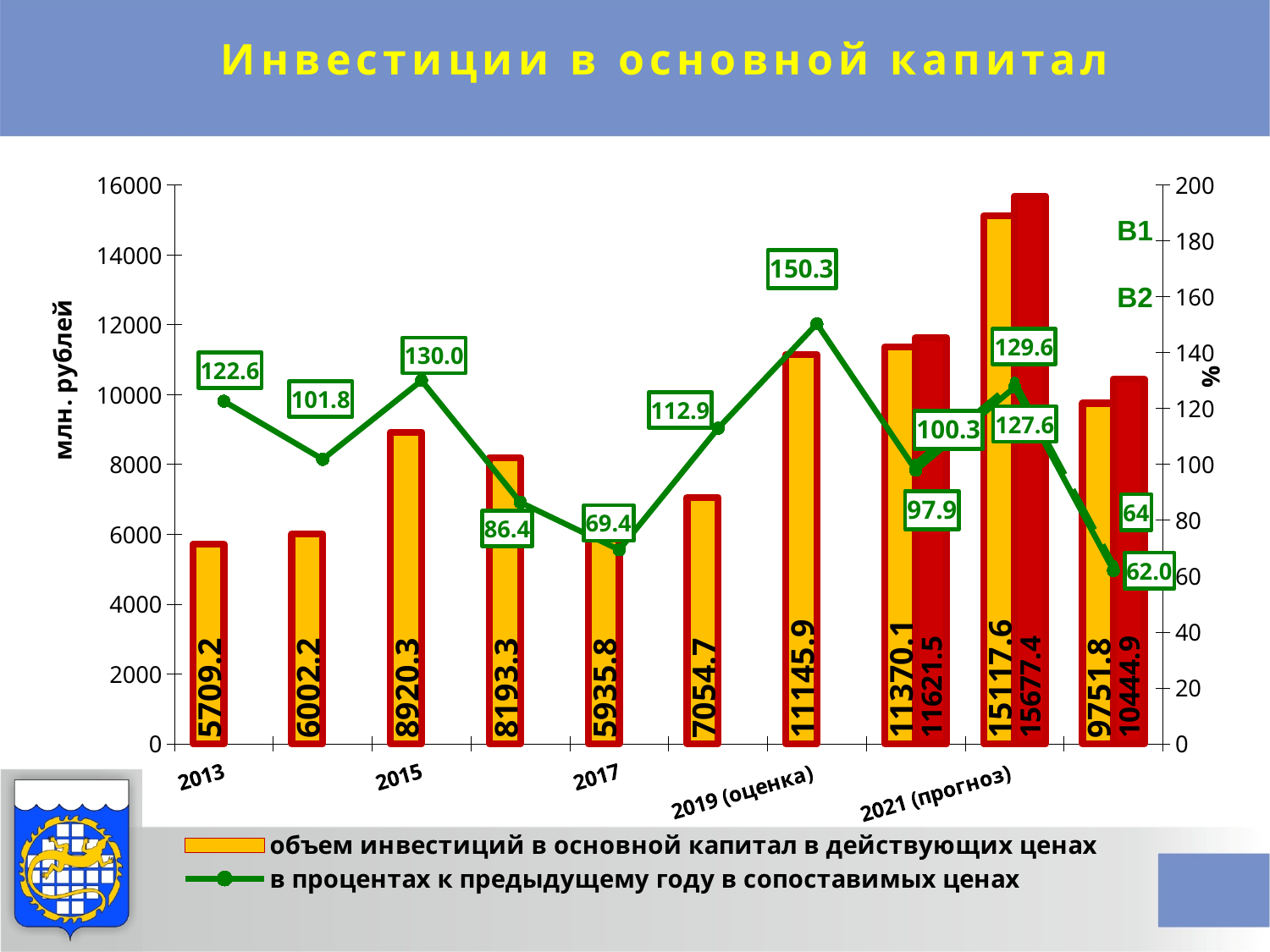
What is the value of the line (в процентах к предыдущему году) for 2019 (оценка)? 150.3 What is the investment volume (orange bar) for 2019 (оценка)? 11145.9 At which x-axis label are the tallest bars located? 2021 (прогноз) What is the label of the left vertical axis? млн. рублей What is the value of the line (в процентах к предыдущему году) for 2013? 122.6 What is the difference between the investment volumes for 2015 and 2013? 3211.1 Which year has a larger investment volume, 2015 or 2017? 2015 At which x-axis label does the line series reach its highest value? 2019 (оценка) How many series does the legend list? 2 What is the investment volume (orange bar) for 2013? 5709.2 What is the investment volume (orange bar) for 2015? 8920.3 What is the investment volume (orange bar) for 2017? 5935.8